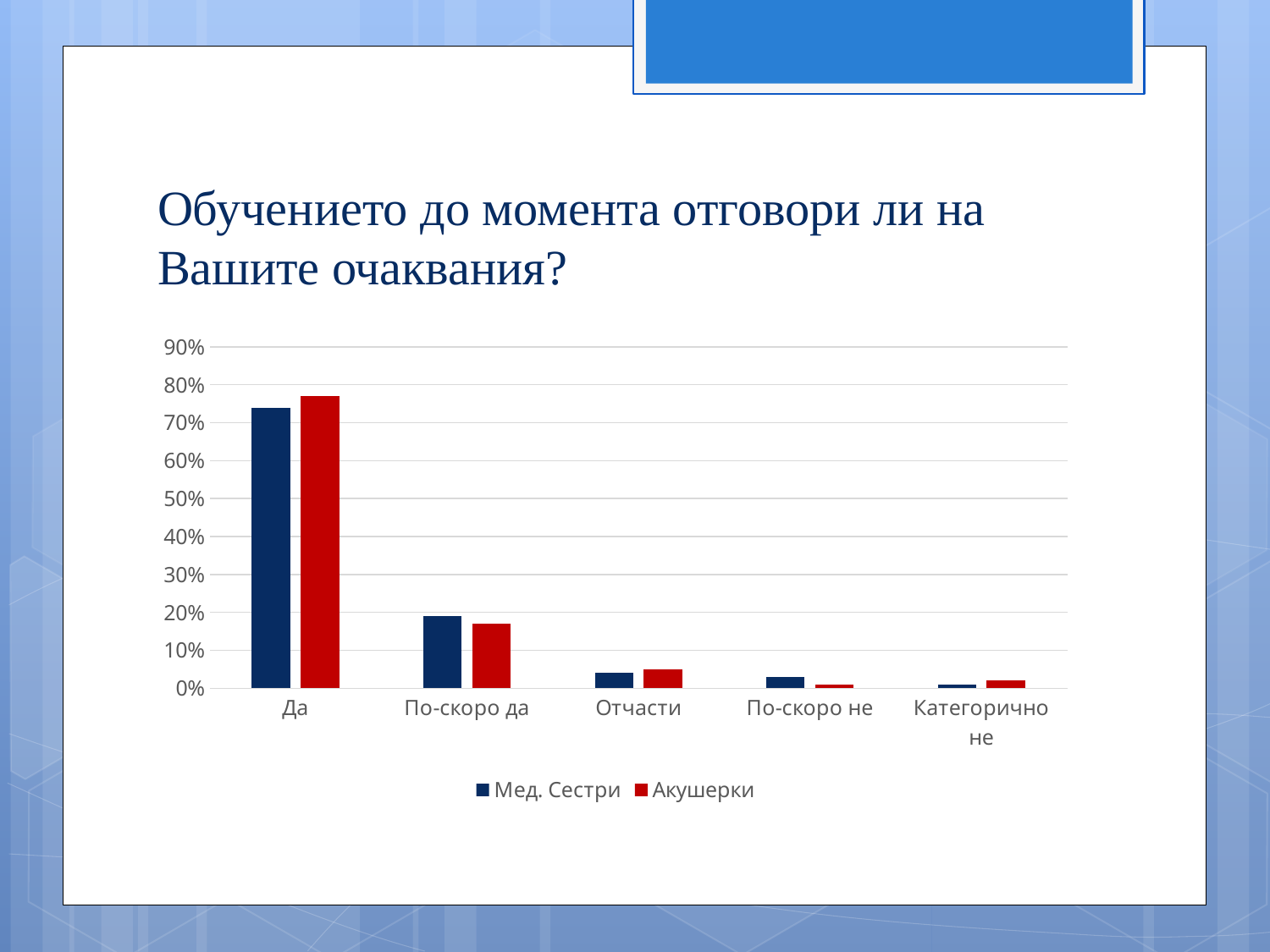
Which series is shown in red in the chart? Акушерки What kind of chart is shown on the slide? bar chart How many categories are shown on the x axis of the chart? 5 How many series does the chart legend list? 2 In the Да category, which series has the larger value, Мед. Сестри or Акушерки? Акушерки Which category has the highest value for Мед. Сестри? Да In the По-скоро не category, which series has the larger value, Мед. Сестри or Акушерки? Мед. Сестри What is the highest value shown on the chart's vertical axis? 90% Is the value for Мед. Сестри in the По-скоро да category greater or less than 30%? less Is the value for Акушерки in the Да category greater or less than 70%? greater Is the value for Мед. Сестри in the Да category greater or less than 60%? greater Which category has the highest value for Акушерки? Да